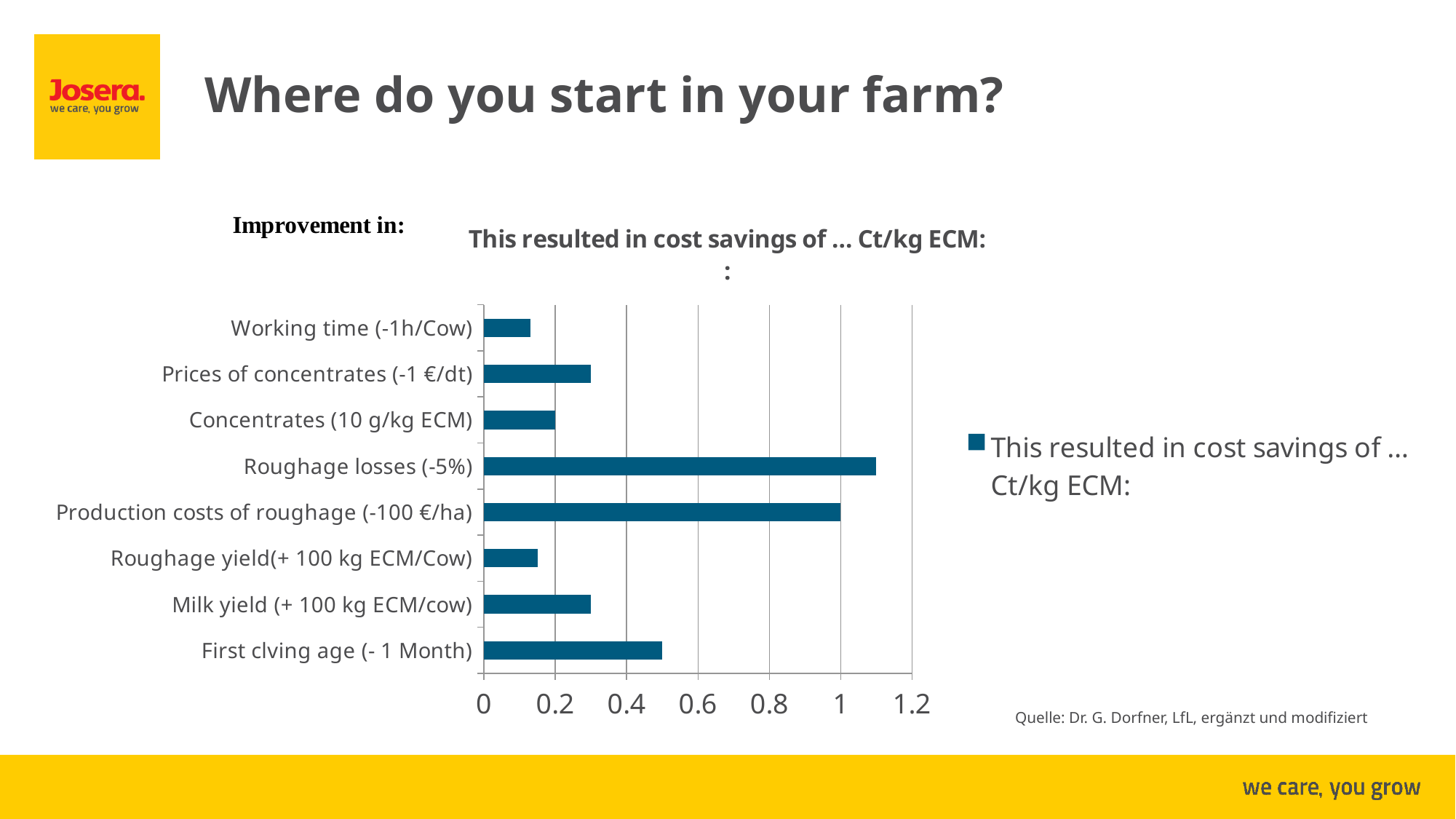
Is the value for Roughage losses (-5%) greater or less than 1? greater How many series does the legend list? 1 What is the cost saving value for Concentrates (10 g/kg ECM)? 0.2 Which category has the highest cost saving? Roughage losses (-5%) Which is larger: the value for First clving age (- 1 Month) or the value for Milk yield (+ 100 kg ECM/cow)? First clving age (- 1 Month) What kind of chart is shown on the slide? bar chart How many categories are plotted on the chart? 8 Is the value for Milk yield (+ 100 kg ECM/cow) greater or less than 0.2? greater Is the value for First clving age (- 1 Month) greater or less than 0.4? greater What is the title of the chart? This resulted in cost savings of ... Ct/kg ECM: What is the cost saving value for Production costs of roughage (-100 €/ha)? 1